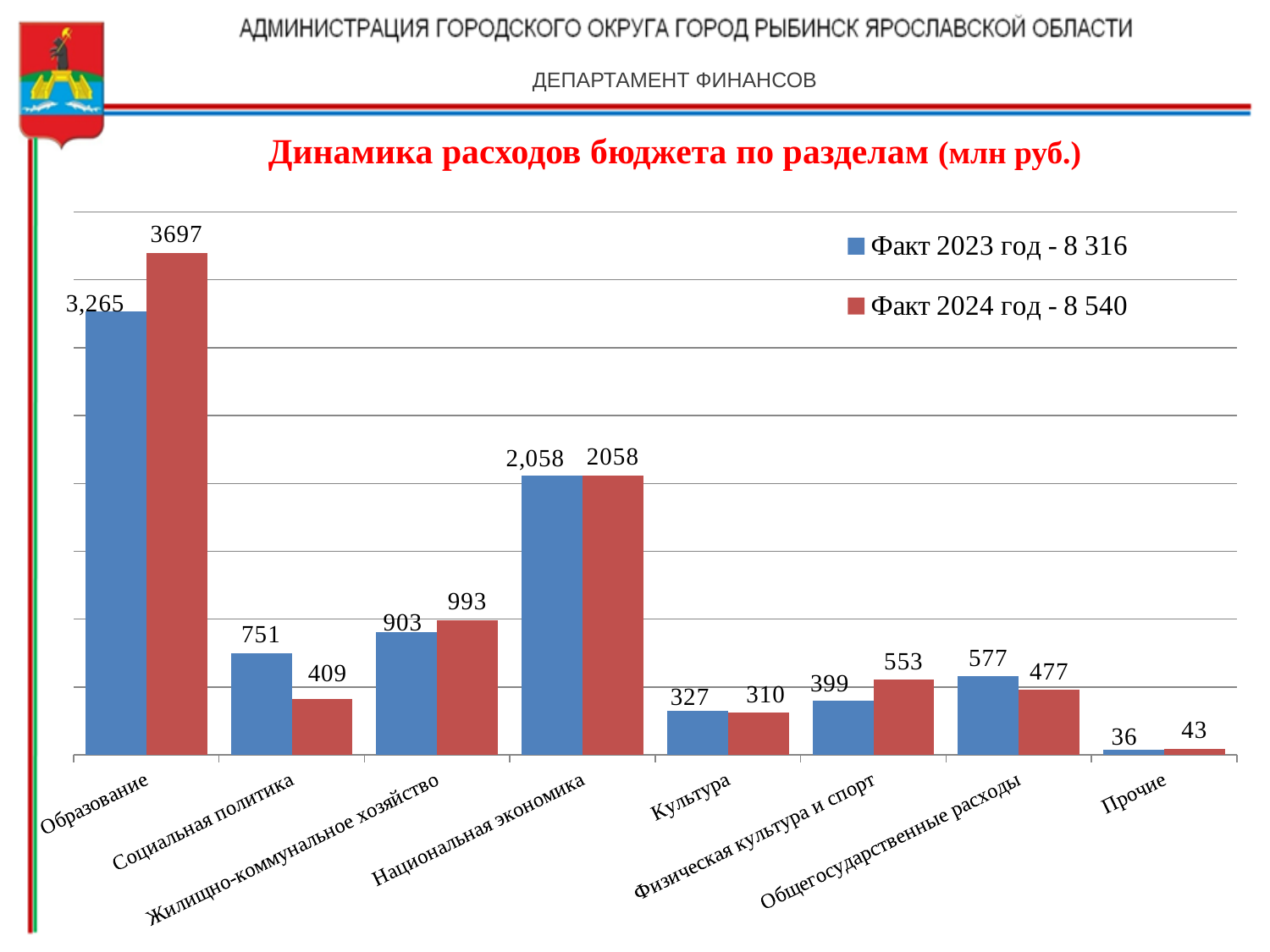
What is the value for Образование in the Факт 2023 год series? 3,265 Which category has the lowest value in the Факт 2023 год series? Прочие What is the value for Физическая культура и спорт in the Факт 2023 год series? 399 What kind of chart is shown on the slide? Bar chart What is the value for Образование in the Факт 2024 год series? 3697 What is the difference between the Факт 2023 год and Факт 2024 год values for Социальная политика? 342 Which is larger for Общегосударственные расходы: the Факт 2023 год value or the Факт 2024 год value? Факт 2023 год How many series does the legend list? 2 How many categories are shown on the x axis? 8 Which category has the highest value in the Факт 2024 год series? Образование What is the value for Социальная политика in the Факт 2024 год series? 409 What is the difference between the Факт 2024 год and Факт 2023 год values for Жилищно-коммунальное хозяйство? 90